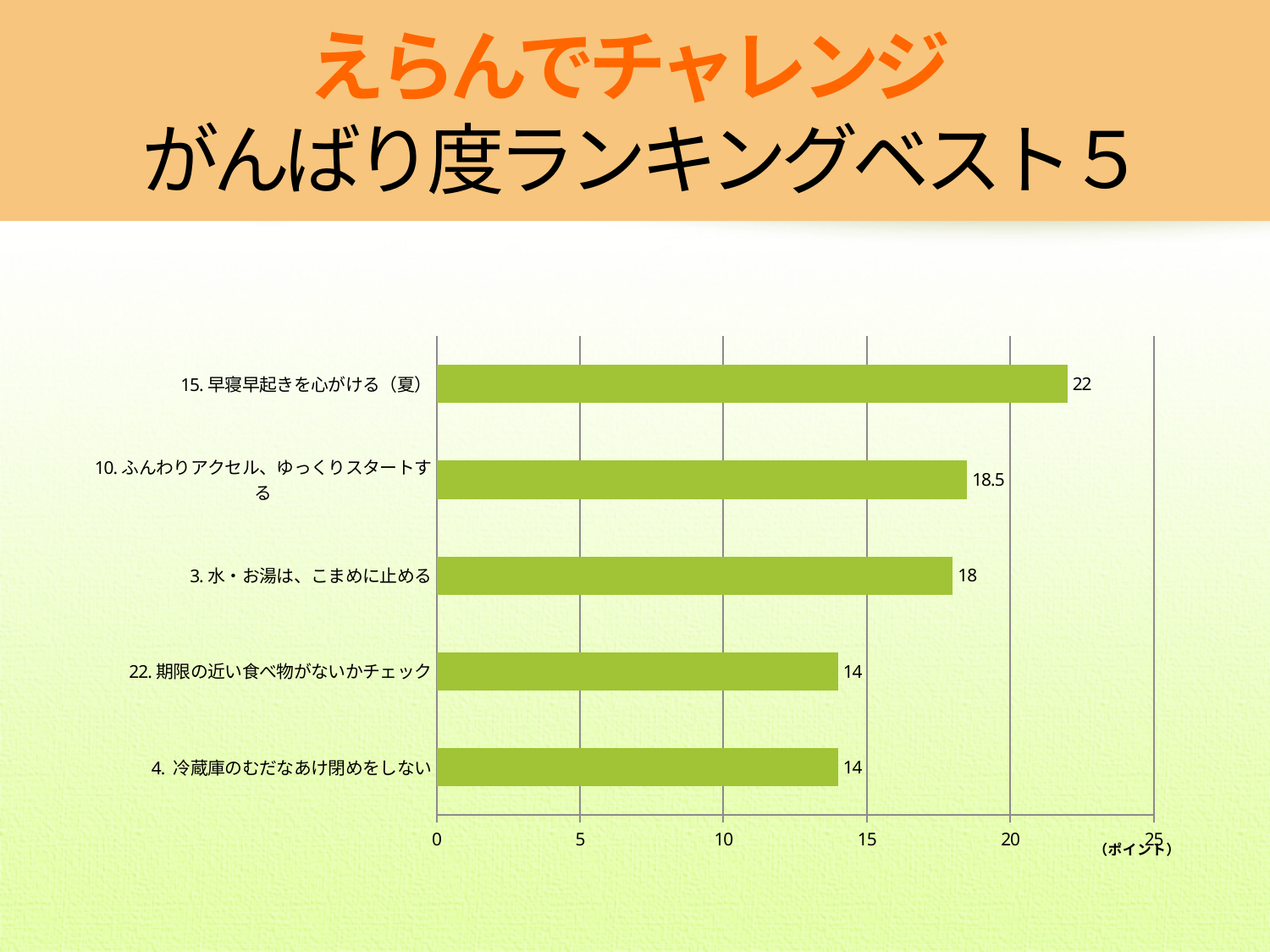
Is the value for 15. 早寝早起きを心がける（夏） greater or less than 20? greater What is the value for 10. ふんわりアクセル、ゆっくりスタートする? 18.5 Which is larger, the value for 10. ふんわりアクセル、ゆっくりスタートする or the value for 22. 期限の近い食べ物がないかチェック? 10. ふんわりアクセル、ゆっくりスタートする What unit is shown next to the horizontal axis? （ポイント） What is the value for 22. 期限の近い食べ物がないかチェック? 14 Which category has the highest value? 15. 早寝早起きを心がける（夏） How many categories are shown in the chart? 5 What is the difference between the values for 15. 早寝早起きを心がける（夏） and 3. 水・お湯は、こまめに止める? 4 What is the value for 3. 水・お湯は、こまめに止める? 18 What is the difference between the values for 10. ふんわりアクセル、ゆっくりスタートする and 4. 冷蔵庫のむだなあけ閉めをしない? 4.5 What is the value for 15. 早寝早起きを心がける（夏）? 22 What kind of chart is shown on the slide? bar chart